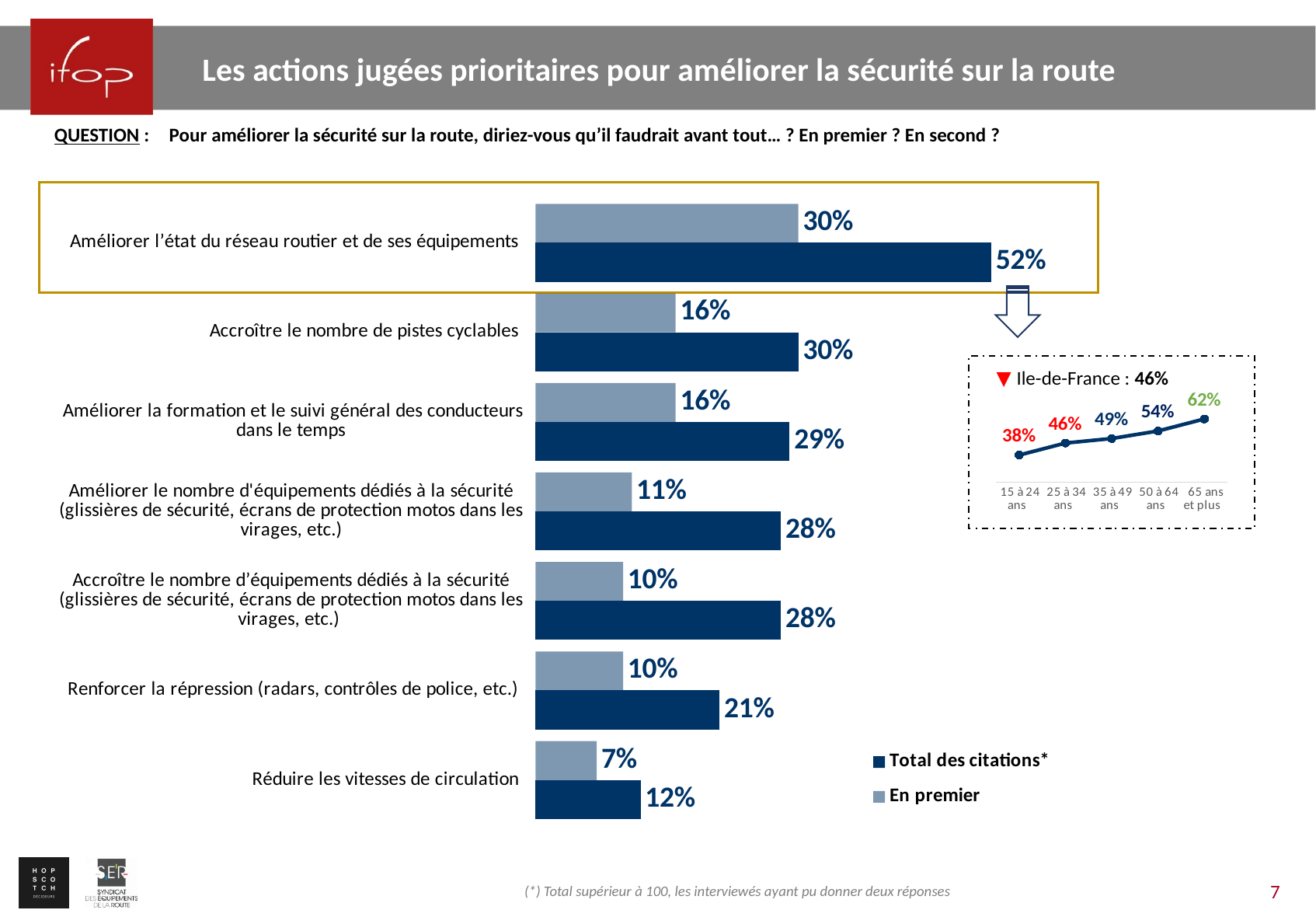
In the main bar chart, what is the difference between the 'Total des citations*' and 'En premier' values for 'Renforcer la répression (radars, contrôles de police, etc.)'? 11% In the small age-group line chart on the right, what is the value for '65 ans et plus'? 62% How many series does the legend of the main bar chart list? 2 In the main bar chart, what is the 'Total des citations*' value for 'Améliorer l'état du réseau routier et de ses équipements'? 52% How many categories does the main bar chart show? 7 What kind of chart is the main chart on the slide? Bar chart In the small age-group line chart on the right, what is the difference between the values for '65 ans et plus' and '15 à 24 ans'? 24% In the small age-group line chart on the right, do the values rise or fall from the youngest to the oldest age group? Rise In the main bar chart, which category has the highest 'Total des citations*' value? Améliorer l'état du réseau routier et de ses équipements In the main bar chart, what is the 'En premier' value for 'Accroître le nombre de pistes cyclables'? 16% In the main bar chart, which is larger: the 'Total des citations*' value for 'Accroître le nombre de pistes cyclables' or for 'Réduire les vitesses de circulation'? Accroître le nombre de pistes cyclables In the main bar chart, which category has the lowest 'En premier' value? Réduire les vitesses de circulation